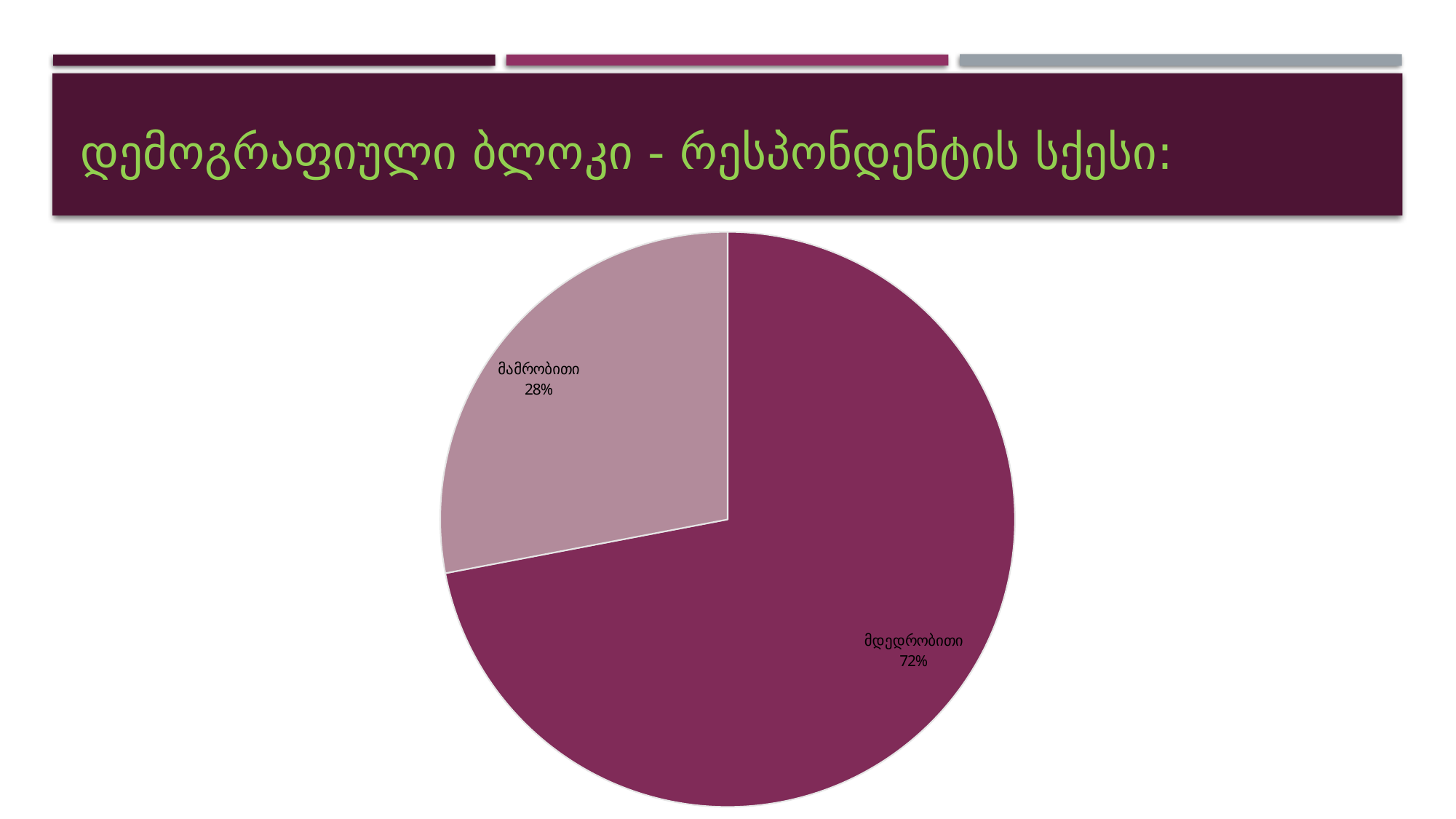
Which slice of the pie is the largest? მდედრობითი What is the difference in percentage points between the მდედრობითი and მამრობითი slices? 44 What share of the pie is labelled მამრობითი? 28% Which slice of the pie is shown in the lighter colour? მამრობითი Which is larger, the მამრობითი slice or the მდედრობითი slice? მდედრობითი What share of the pie is labelled მდედრობითი? 72% What kind of chart is shown on the slide? pie chart How many slices does the pie chart have? 2 Which slice of the pie is the smallest? მამრობითი What is the title of the slide containing the pie chart? დემოგრაფიული ბლოკი - რესპონდენტის სქესი: